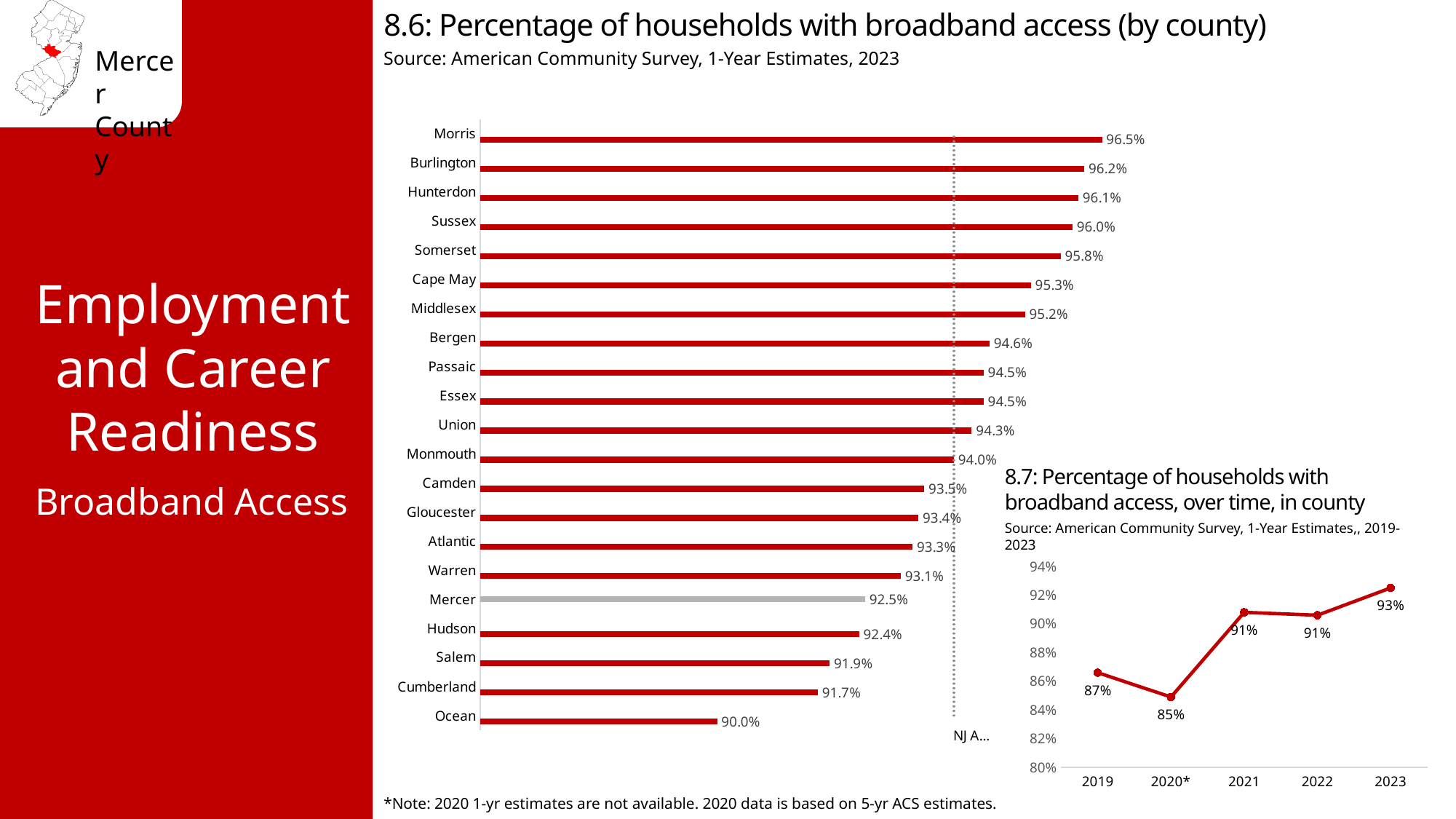
In chart 8.6 (by county), which has a higher value, Hudson or Salem? Hudson In chart 8.7 (broadband access over time in county), what is the value for 2020*? 85% In chart 8.6 (by county), which county has the highest percentage of households with broadband access? Morris In chart 8.6 (by county), what is the value for Cumberland? 91.7% In chart 8.7 (broadband access over time in county), what is the value for 2023? 93% In chart 8.6 (by county), what is the difference between the values for Morris and Ocean? 6.5% In chart 8.6 (Percentage of households with broadband access by county), what is the value for Mercer? 92.5% What kind of chart is chart 8.7 (Percentage of households with broadband access over time in county)? Line chart In chart 8.6 (by county), how many counties are shown? 21 In chart 8.7 (broadband access over time in county), what is the difference between the 2023 and 2019 values? 6% What kind of chart is chart 8.6 (Percentage of households with broadband access by county)? Bar chart In chart 8.6 (by county), which county has the lowest percentage of households with broadband access? Ocean